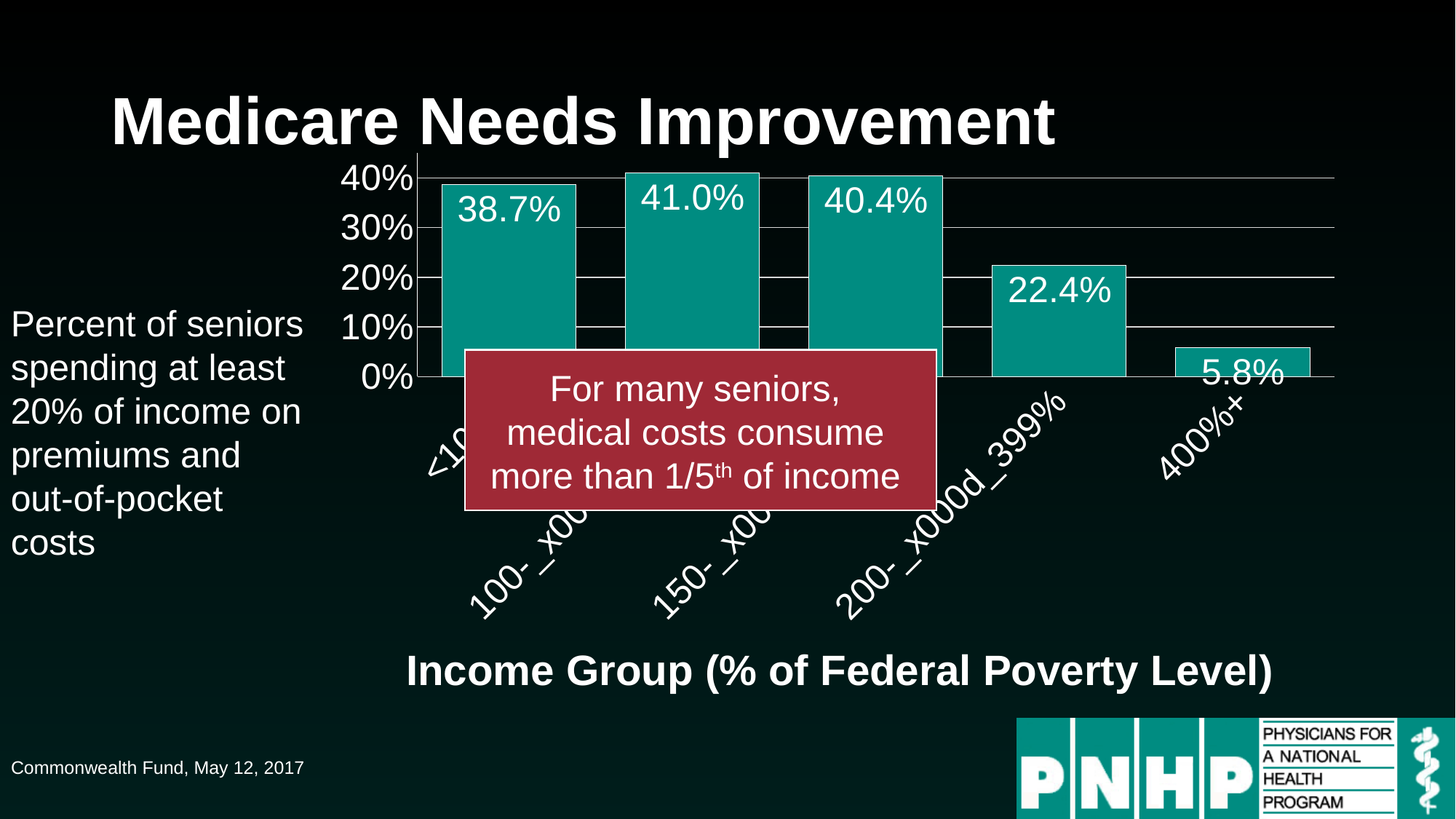
What kind of chart is shown on the slide? bar chart What is the value shown on the second bar from the left? 41.0% Which income group has the lowest value? 400%+ What is the value shown on the fourth bar from the left? 22.4% How many bars does the chart show? 5 What is the highest value shown on the chart? 41.0% What is the value shown on the third bar from the left? 40.4% What is the difference between the fourth bar (22.4%) and the 400%+ bar (5.8%)? 16.6% Is the value for the 400%+ income group greater or less than 10%? less What is the value for the 400%+ income group? 5.8% What is the x-axis title of the chart? Income Group (% of Federal Poverty Level) What is the value shown on the first bar from the left? 38.7%